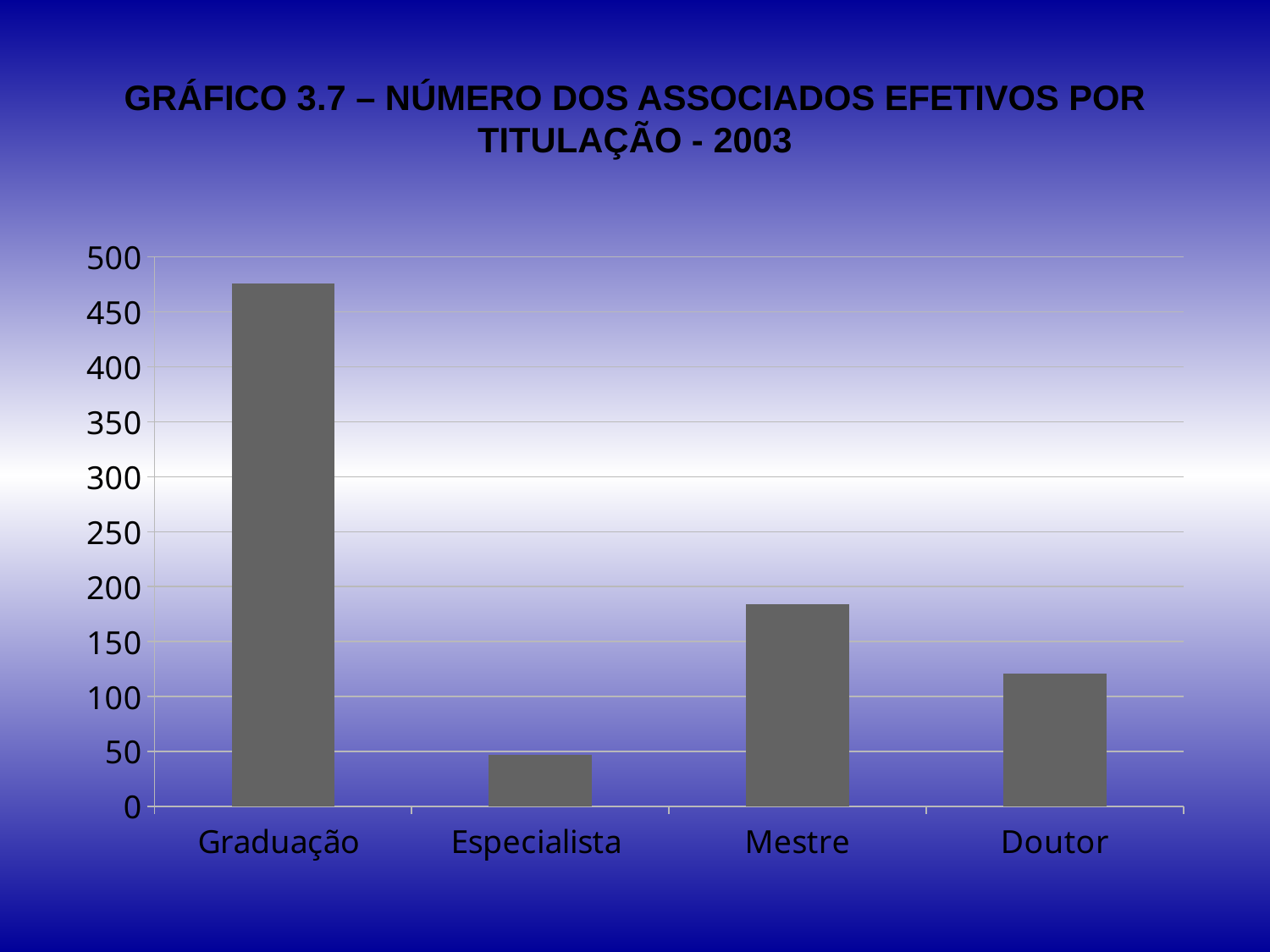
How many categories are shown on the x axis of the chart? 4 What kind of chart is shown on the slide? bar chart What is the title of the chart on the slide? GRÁFICO 3.7 – NÚMERO DOS ASSOCIADOS EFETIVOS POR TITULAÇÃO - 2003 Is the value for Graduação greater or less than 450? greater Is the value for Especialista greater or less than 100? less Which is larger, the value for Mestre or the value for Doutor? Mestre Is the value for Mestre greater or less than 200? less Which is larger, the value for Especialista or the value for Doutor? Doutor Which category has the lowest value in the chart? Especialista Which category has the highest value in the chart? Graduação